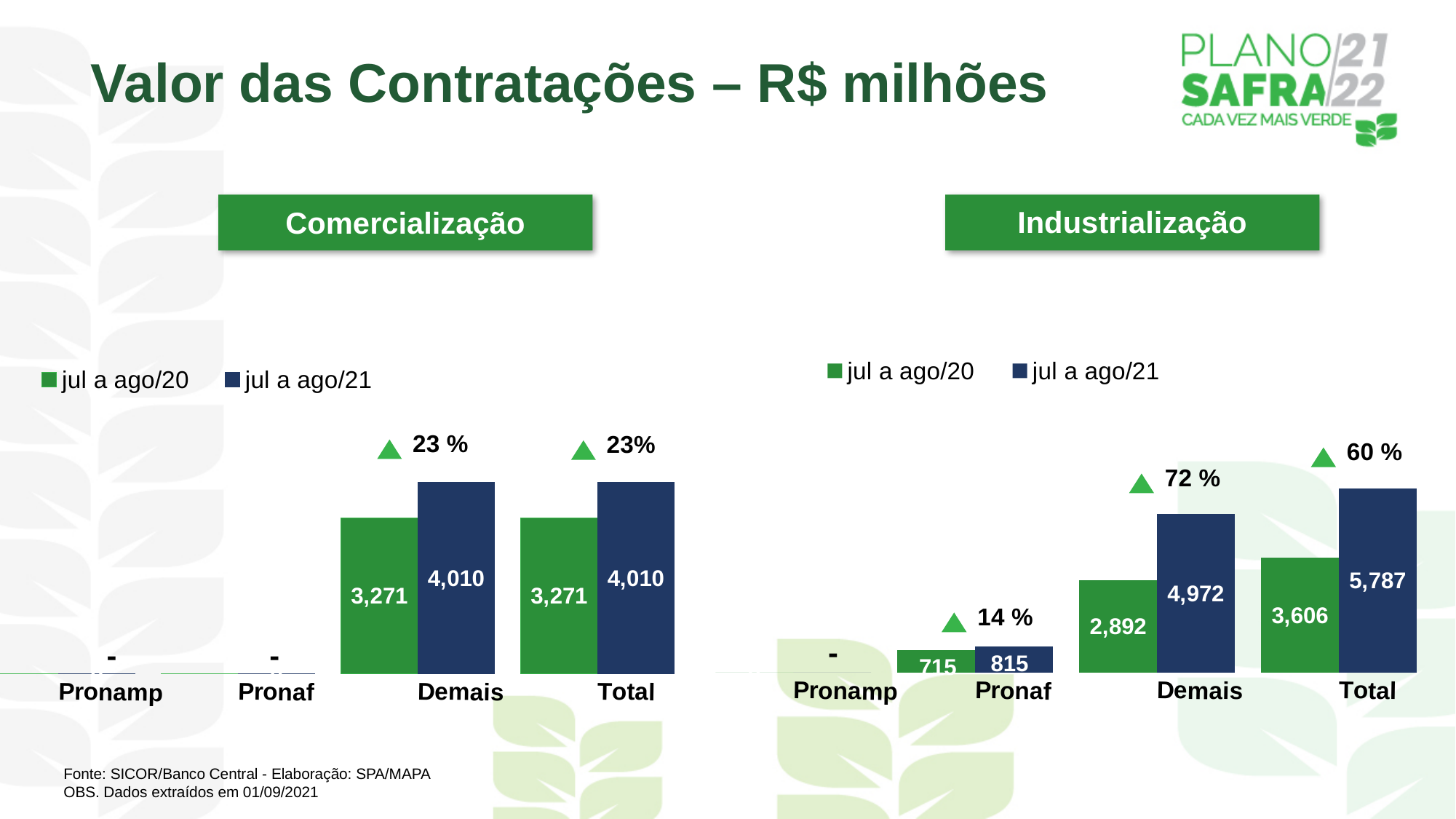
In the Comercialização chart, what is the value for Demais in jul a ago/21? 4,010 What kind of chart is the Comercialização chart? Bar chart In the Industrialização chart, what is the value for Total in jul a ago/21? 5,787 In the Comercialização chart, what is the difference between the jul a ago/21 and jul a ago/20 values for Demais? 739 In the Industrialização chart, what is the difference between the jul a ago/21 and jul a ago/20 values for Total? 2,181 In the Industrialização chart, which category has the highest jul a ago/21 value? Total How many series does the legend of the Industrialização chart list? 2 How many categories are shown on the x axis of the Comercialização chart? 4 In the Comercialização chart, what is the value for Total in jul a ago/20? 3,271 In the Industrialização chart, which is larger for Demais: jul a ago/20 or jul a ago/21? jul a ago/21 In the Industrialização chart, what is the value for Demais in jul a ago/21? 4,972 In the Industrialização chart, what is the value for Pronaf in jul a ago/20? 715